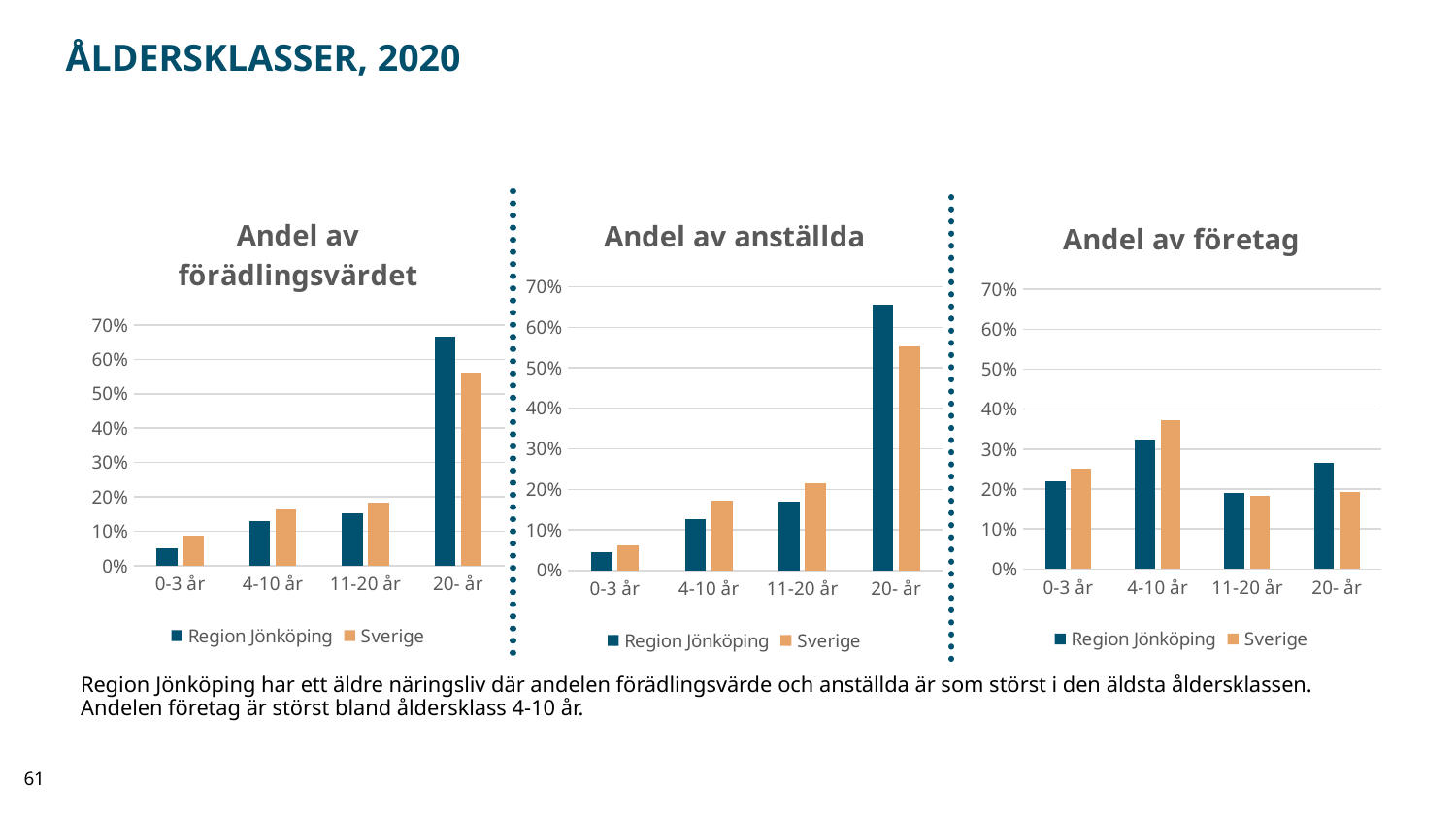
In the "Andel av företag" chart, which age category has the highest value for Region Jönköping? 4-10 år In the "Andel av förädlingsvärdet" chart, is the value for Region Jönköping in 20- år greater or less than 60%? greater What kind of chart is "Andel av anställda"? bar chart How many series does the legend of the "Andel av företag" chart list? 2 In the "Andel av företag" chart, which is larger for 0-3 år: Region Jönköping or Sverige? Sverige In the "Andel av anställda" chart, do the Sverige values rise or fall from 0-3 år to 20- år? rise In the "Andel av företag" chart, is the value for Sverige in 4-10 år greater or less than 30%? greater In the "Andel av förädlingsvärdet" chart, which age category has the highest value for Region Jönköping? 20- år How many age categories are shown on the x axis of the "Andel av förädlingsvärdet" chart? 4 In the "Andel av anställda" chart, which age category has the lowest value for Region Jönköping? 0-3 år In the "Andel av anställda" chart, which is larger for 20- år: Region Jönköping or Sverige? Region Jönköping What are the two legend entries in the "Andel av förädlingsvärdet" chart? Region Jönköping and Sverige